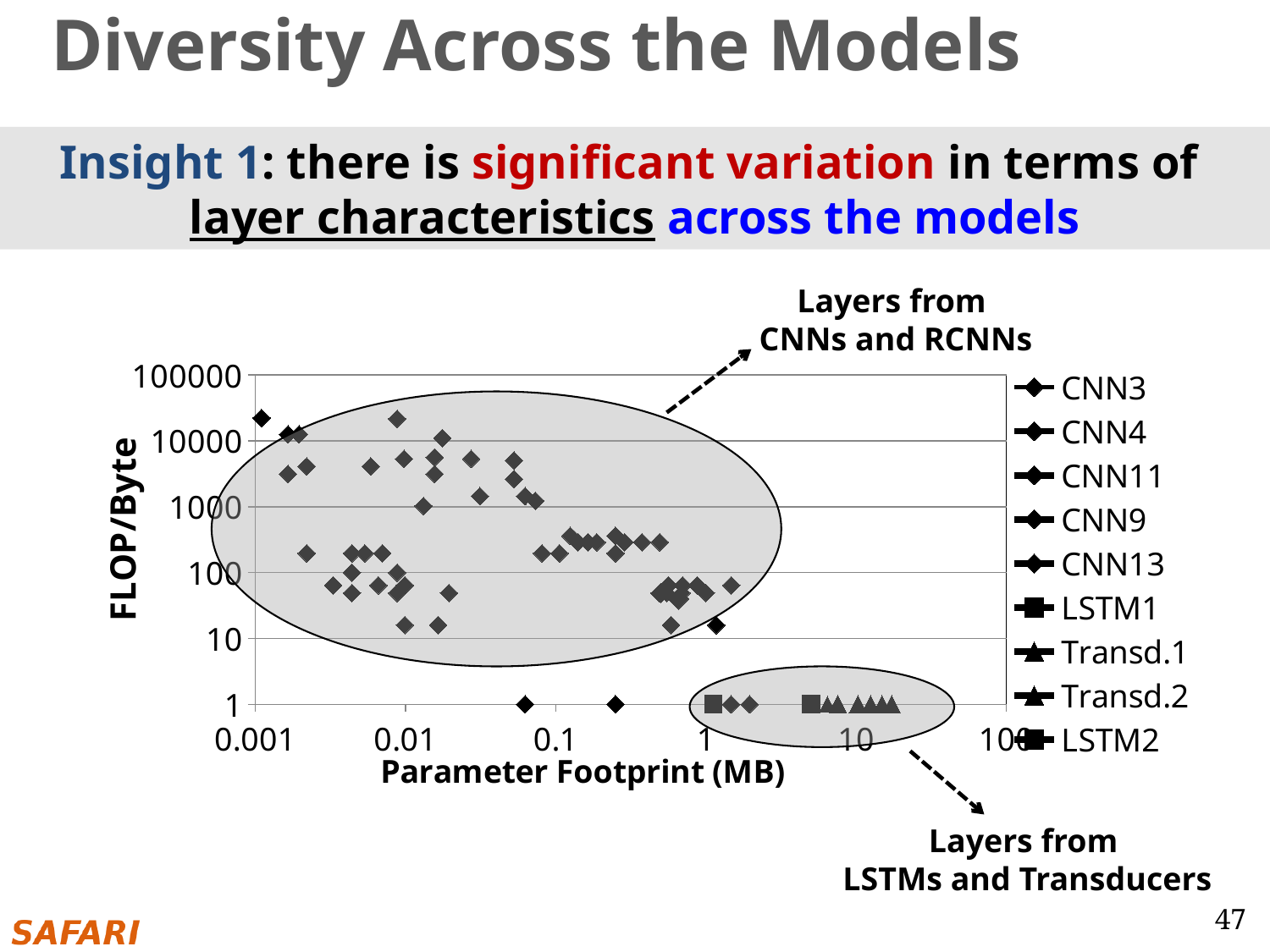
What is the label of the x-axis of the chart? Parameter Footprint (MB) Which group of layers has higher FLOP/Byte values: the layers from CNNs and RCNNs or the layers from LSTMs and Transducers? Layers from CNNs and RCNNs What is the label of the y-axis of the chart? FLOP/Byte What kind of chart is shown on the slide? Scatter plot How many series does the legend of the chart list? 9 How many CNN series are listed in the legend? 5 Is the parameter footprint of the layers from LSTMs and Transducers greater or less than 0.1 MB? greater What is the lowest value shown on the x-axis of the chart? 0.001 According to the annotation, which models do the layers in the lower-right ellipse come from? LSTMs and Transducers Are the FLOP/Byte values of the layers from LSTMs and Transducers greater or less than 10? less According to the annotation, which models do the layers in the large upper ellipse come from? CNNs and RCNNs What is the highest value shown on the y-axis of the chart? 100000